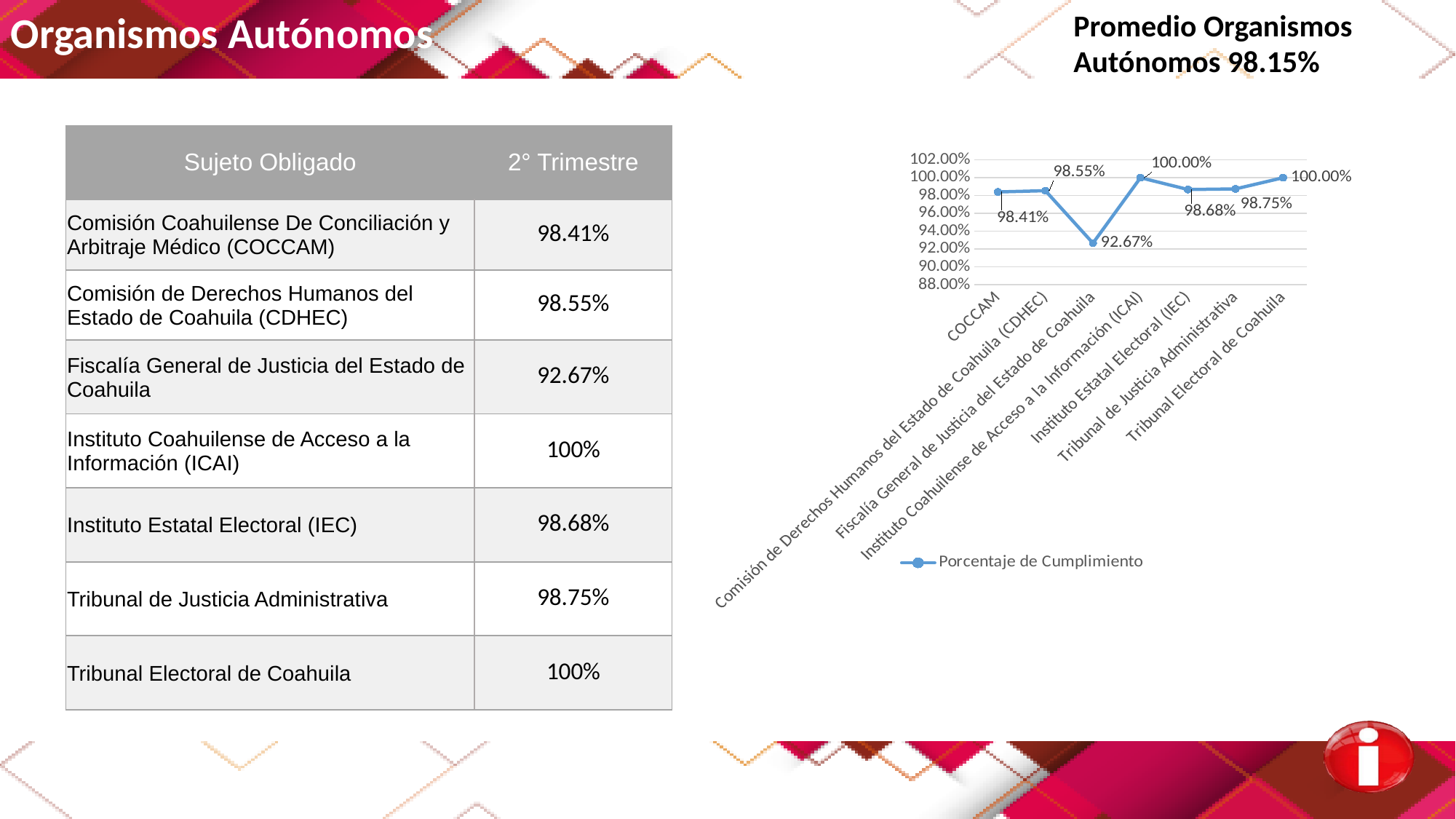
How many series does the chart legend list? 1 What is the value for COCCAM in the chart? 98.41% What kind of chart is shown on the slide? line chart What is the value for Fiscalía General de Justicia del Estado de Coahuila in the chart? 92.67% What is the difference between the values for Tribunal de Justicia Administrativa and Fiscalía General de Justicia del Estado de Coahuila? 6.08% Which category has the lowest value in the chart? Fiscalía General de Justicia del Estado de Coahuila Which is larger, the value for COCCAM or the value for Comisión de Derechos Humanos del Estado de Coahuila (CDHEC)? Comisión de Derechos Humanos del Estado de Coahuila (CDHEC) Is the value for Fiscalía General de Justicia del Estado de Coahuila greater or less than 94.00%? less How many categories are plotted in the chart? 7 What is the value for Instituto Estatal Electoral (IEC) in the chart? 98.68% What is the name of the series shown in the chart legend? Porcentaje de Cumplimiento What is the value for Tribunal de Justicia Administrativa in the chart? 98.75%